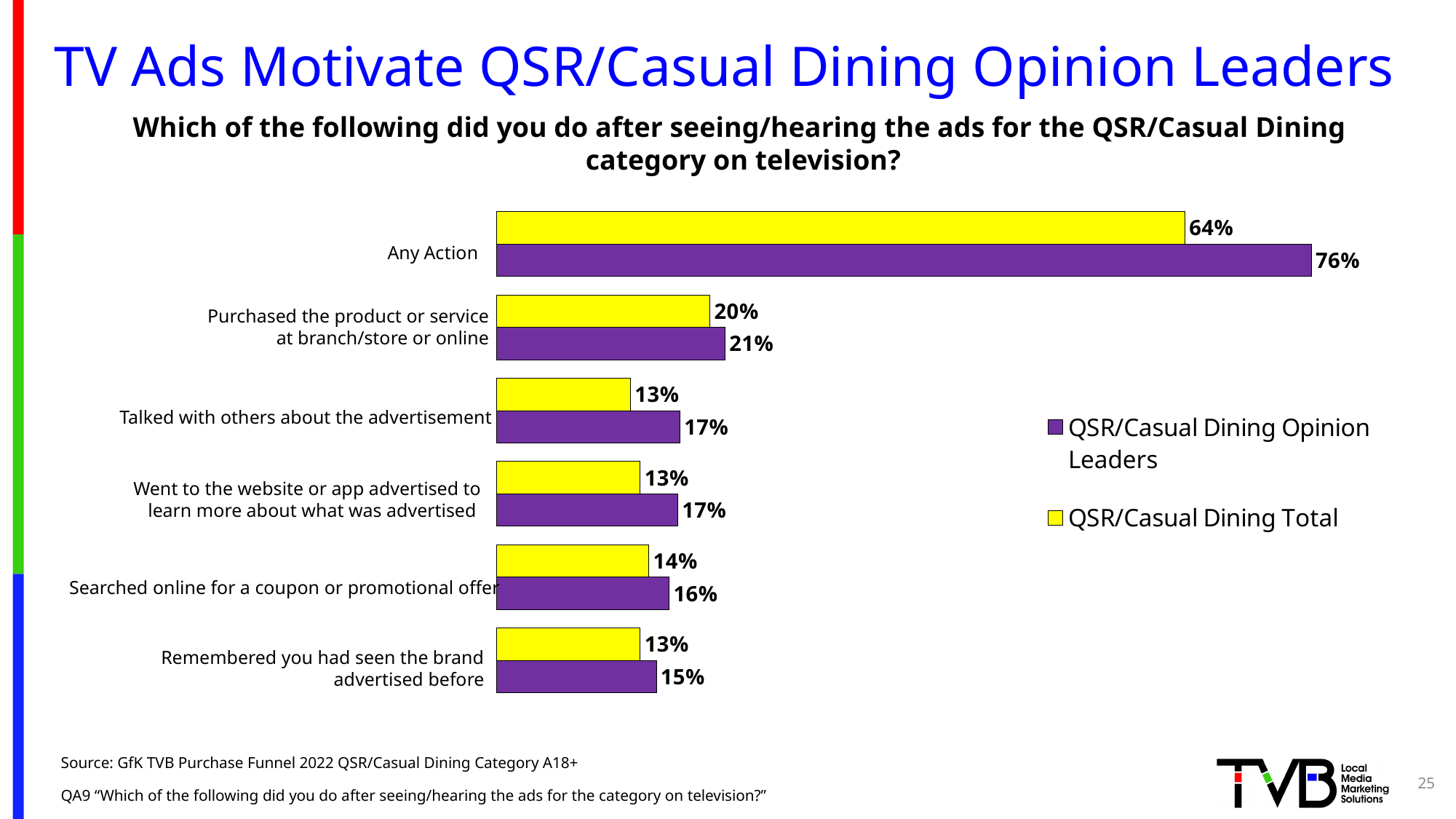
What is the value for QSR/Casual Dining Opinion Leaders for Purchased the product or service at branch/store or online? 21% What is the value for QSR/Casual Dining Total for Any Action? 64% What is the difference between the QSR/Casual Dining Opinion Leaders and QSR/Casual Dining Total values for Any Action? 12% How many categories are shown on the chart? 6 What is the value for QSR/Casual Dining Opinion Leaders for Any Action? 76% Which category has the highest value for QSR/Casual Dining Opinion Leaders? Any Action What is the value for QSR/Casual Dining Total for Searched online for a coupon or promotional offer? 14% How many series does the legend list? 2 What is the difference between the QSR/Casual Dining Opinion Leaders and QSR/Casual Dining Total values for Talked with others about the advertisement? 4% What kind of chart is shown on the slide? Bar chart Which category has the lowest value for QSR/Casual Dining Opinion Leaders? Remembered you had seen the brand advertised before Which is larger for Searched online for a coupon or promotional offer: QSR/Casual Dining Opinion Leaders or QSR/Casual Dining Total? QSR/Casual Dining Opinion Leaders